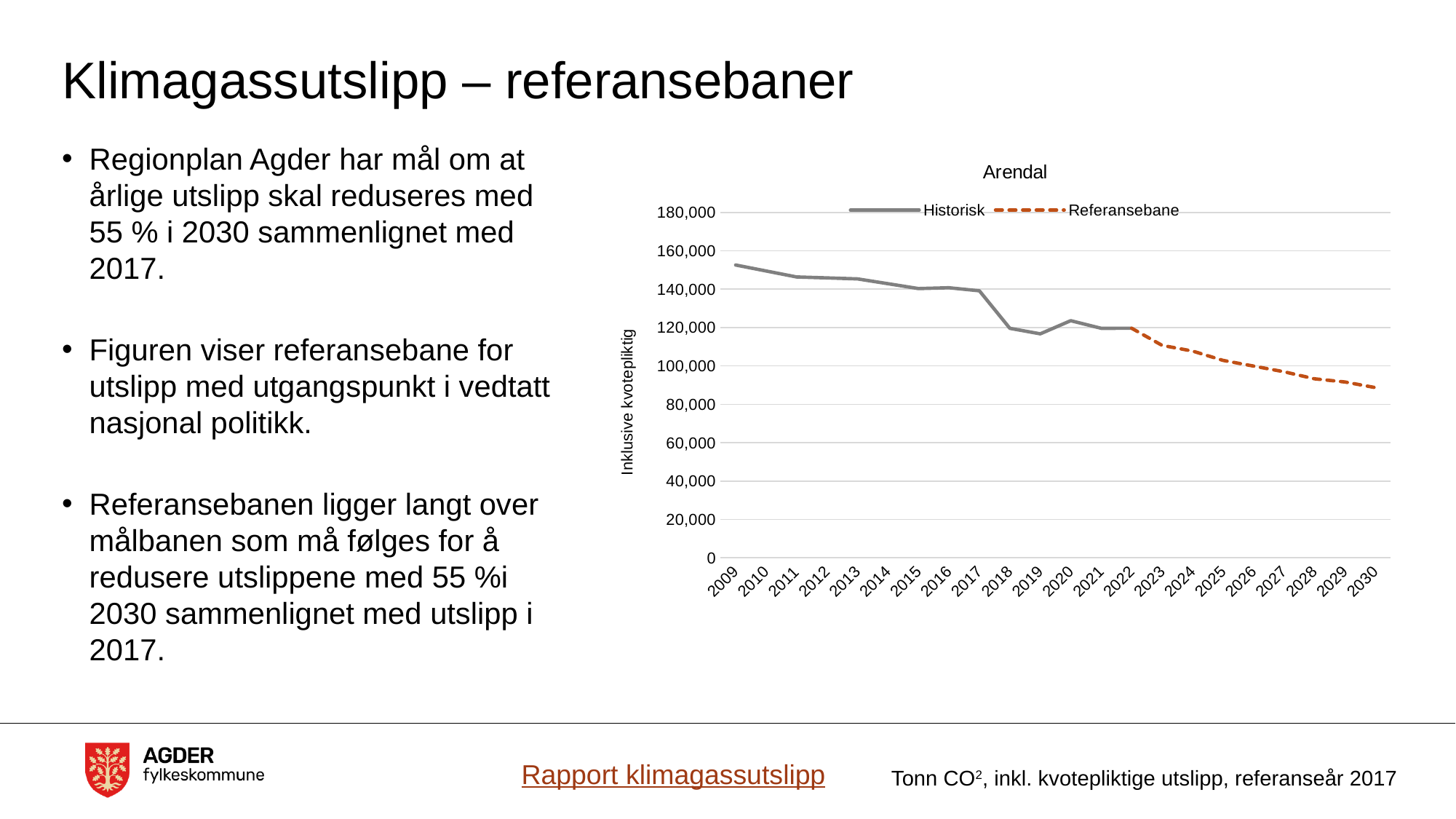
What is the title of the chart? Arendal Is the value for 2030 greater or less than 100,000? less Is the value for 2018 greater or less than 140,000? less How many years are shown on the x axis of the chart? 22 Do the values in the chart generally rise or fall from 2009 to 2030? fall Which series is drawn with a dashed line? Referansebane What kind of chart is shown on the slide? line chart Is the value for 2009 greater or less than 140,000? greater Which year has the lowest value in the chart? 2030 How many series does the chart legend list? 2 Which year has the highest value in the chart? 2009 Which year has the larger value, 2009 or 2030? 2009